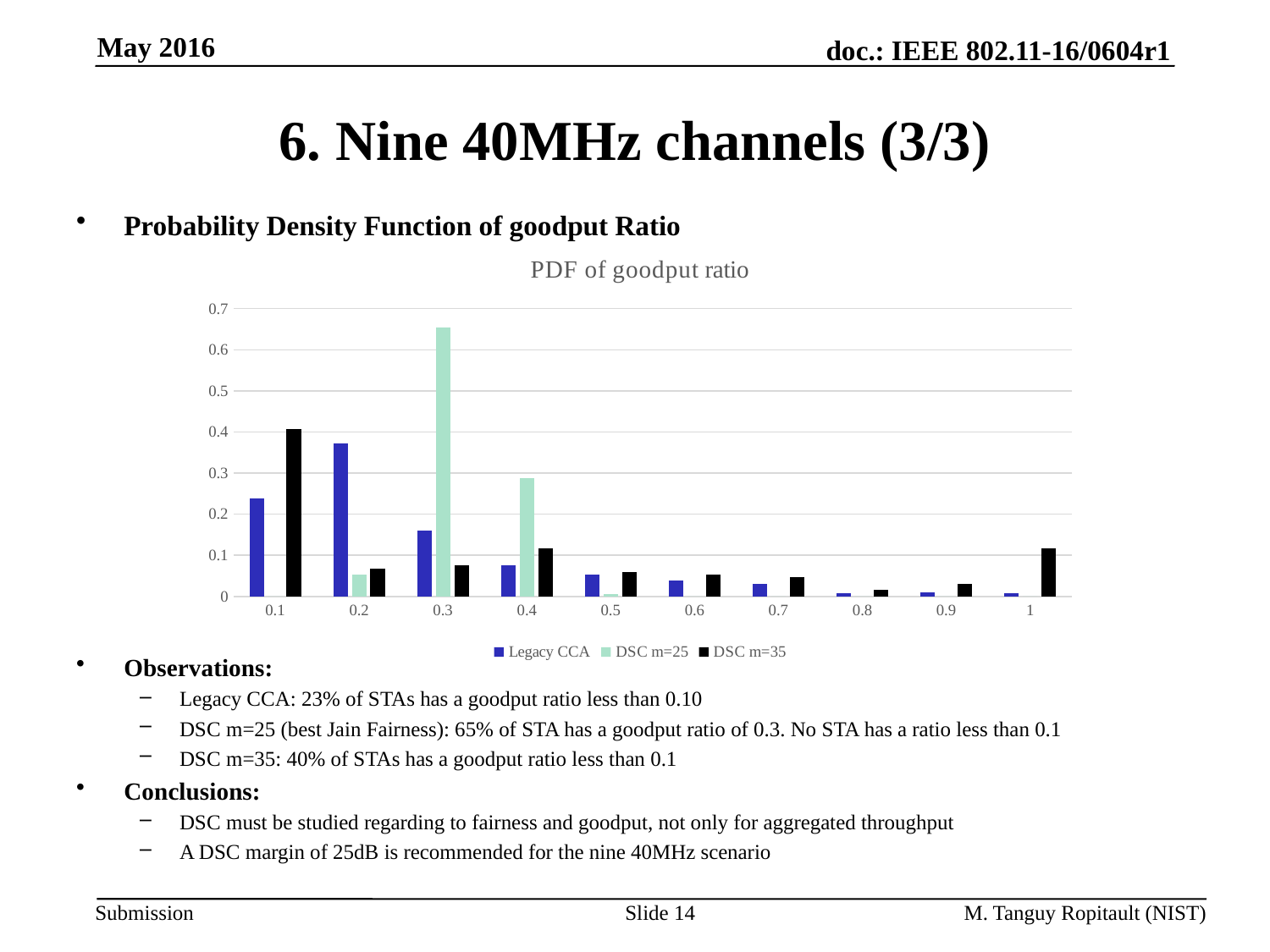
At which goodput ratio does the Legacy CCA series reach its highest value? 0.2 At which goodput ratio does the DSC m=25 series reach its highest value? 0.3 How many series does the legend list? 3 At which goodput ratio does the DSC m=35 series reach its highest value? 0.1 How many goodput ratio categories are shown on the x axis? 10 What kind of chart is shown on the slide? bar chart At goodput ratio 0.4, which series has the larger value, DSC m=25 or DSC m=35? DSC m=25 What is the title of the chart? PDF of goodput ratio Is the value for Legacy CCA at goodput ratio 0.1 greater or less than 0.3? less Is the value for DSC m=25 at goodput ratio 0.3 greater or less than 0.6? greater